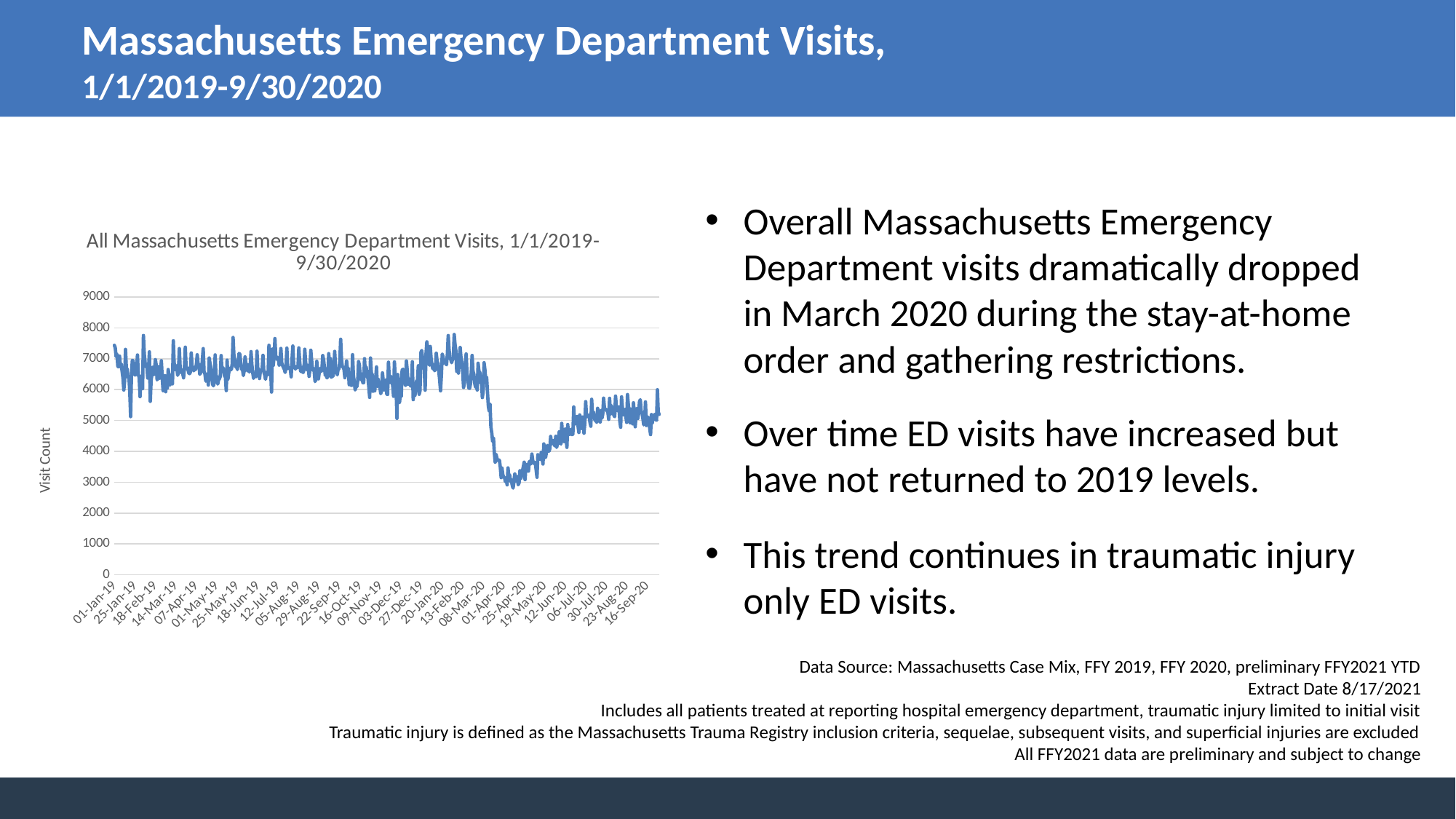
What is the highest tick value shown on the vertical axis of the chart? 9000 What is the label on the vertical axis of the chart? Visit Count Which is larger: the visit count at 01-Jan-19 or the visit count around 25-Apr-20? 01-Jan-19 What is the title of the chart on the slide? All Massachusetts Emergency Department Visits, 1/1/2019-9/30/2020 What is the first date label on the horizontal axis of the chart? 01-Jan-19 Do visit counts rise or fall between 25-Apr-20 and 06-Jul-20? rise Is the visit count at 01-Jan-19 greater or less than 6000? greater What is the last date label on the horizontal axis of the chart? 16-Sep-20 Is the visit count around 16-Sep-20 greater or less than 4000? greater Is the visit count around 25-Apr-20 greater or less than 4000? less Do visit counts rise or fall between 08-Mar-20 and 01-Apr-20? fall What type of chart is shown on the slide? Line chart